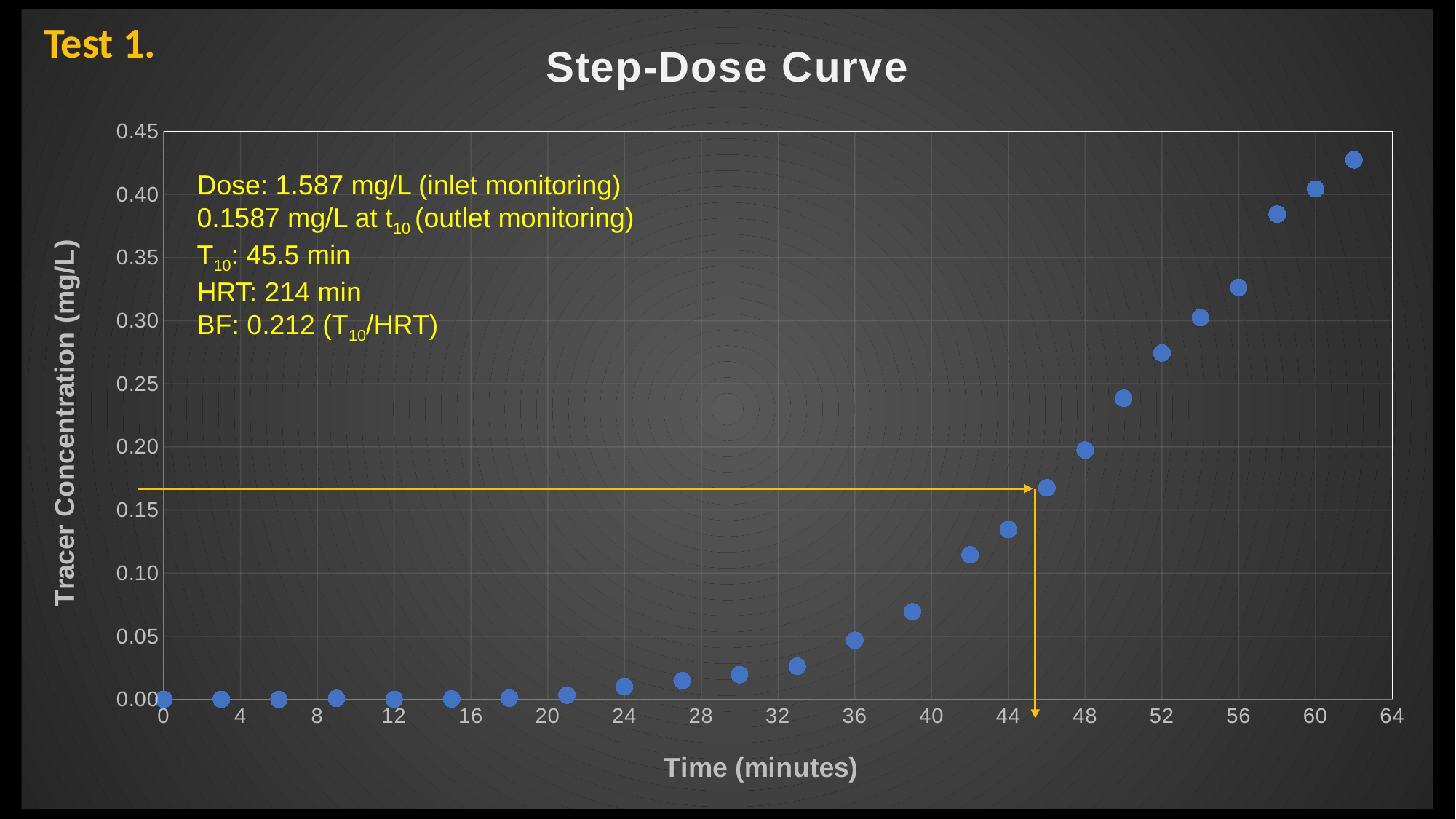
Is the tracer concentration at 58 minutes greater or less than 0.40? less Is the tracer concentration at 24 minutes greater or less than 0.05? less Is the tracer concentration at 42 minutes greater or less than 0.10? greater At which time (in minutes) is the tracer concentration highest? 62 Do the tracer concentration values rise or fall as time increases along the x axis? rise What T10 value is annotated on the chart? 45.5 min What is the title of the y axis? Tracer Concentration (mg/L) What kind of chart is the Step-Dose Curve? scatter chart Which has the larger tracer concentration, 56 minutes or 44 minutes? 56 minutes